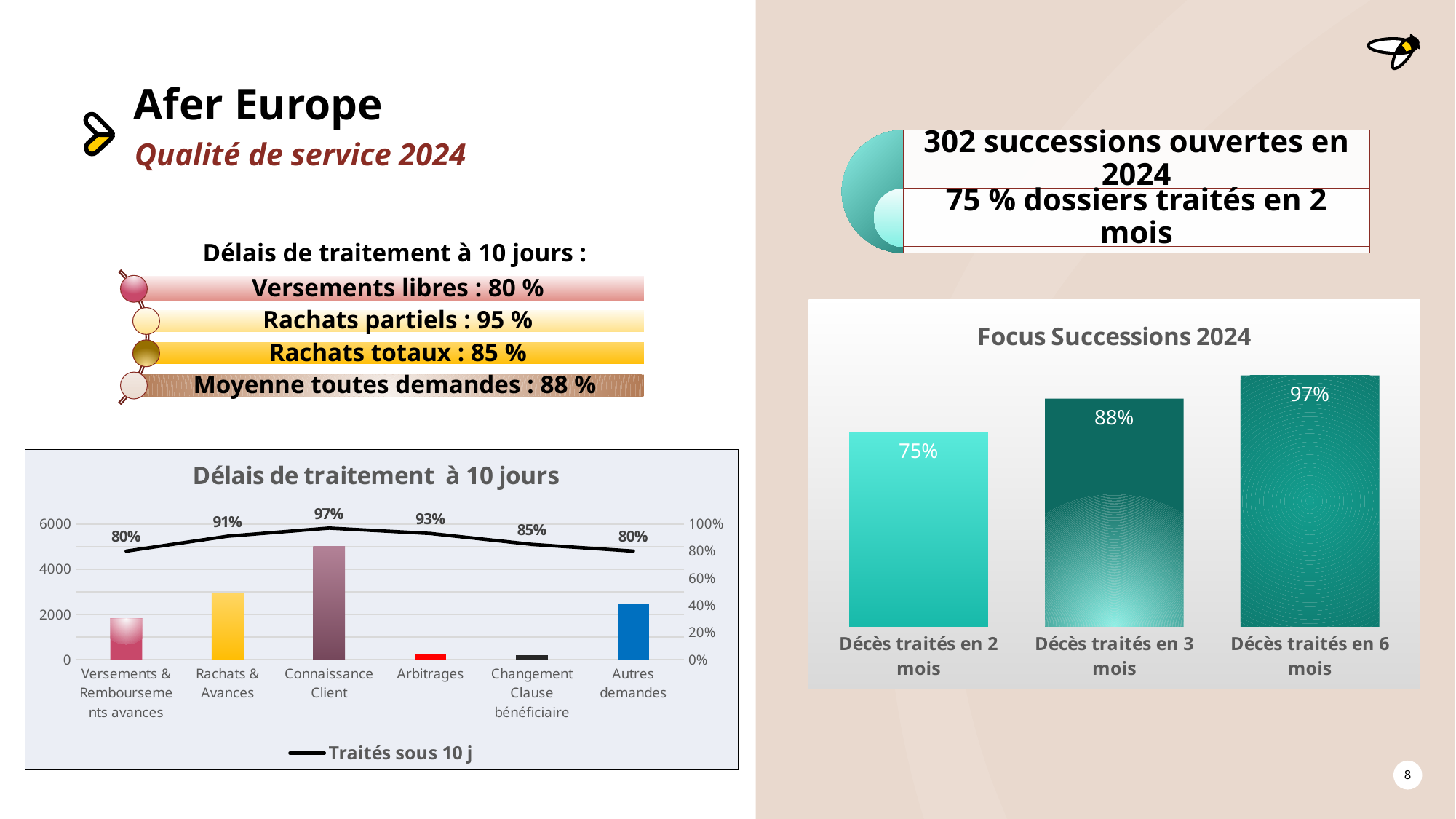
What is the only entry in the legend of the 'Délais de traitement à 10 jours' chart? Traités sous 10 j In the 'Délais de traitement à 10 jours' chart, what is the 'Traités sous 10 j' value for Connaissance Client? 97% In the 'Focus Successions 2024' chart, what is the difference between 'Décès traités en 6 mois' and 'Décès traités en 2 mois'? 22% In the 'Délais de traitement à 10 jours' chart, which category has the highest 'Traités sous 10 j' percentage? Connaissance Client In the 'Délais de traitement à 10 jours' chart, what is the difference between the 'Traités sous 10 j' percentages for Rachats & Avances and Changement Clause bénéficiaire? 6% What kind of chart is 'Focus Successions 2024'? Bar chart How many categories are shown on the x axis of the 'Délais de traitement à 10 jours' chart? 6 In the 'Délais de traitement à 10 jours' chart, which bar is taller: Rachats & Avances or Autres demandes? Rachats & Avances In the 'Focus Successions 2024' chart, what is the value for 'Décès traités en 3 mois'? 88% In the 'Délais de traitement à 10 jours' chart, is the bar for Connaissance Client greater or less than 4000? greater In the 'Délais de traitement à 10 jours' chart, is the bar for Arbitrages greater or less than 2000? less In the 'Délais de traitement à 10 jours' chart, what is the 'Traités sous 10 j' value for Arbitrages? 93%